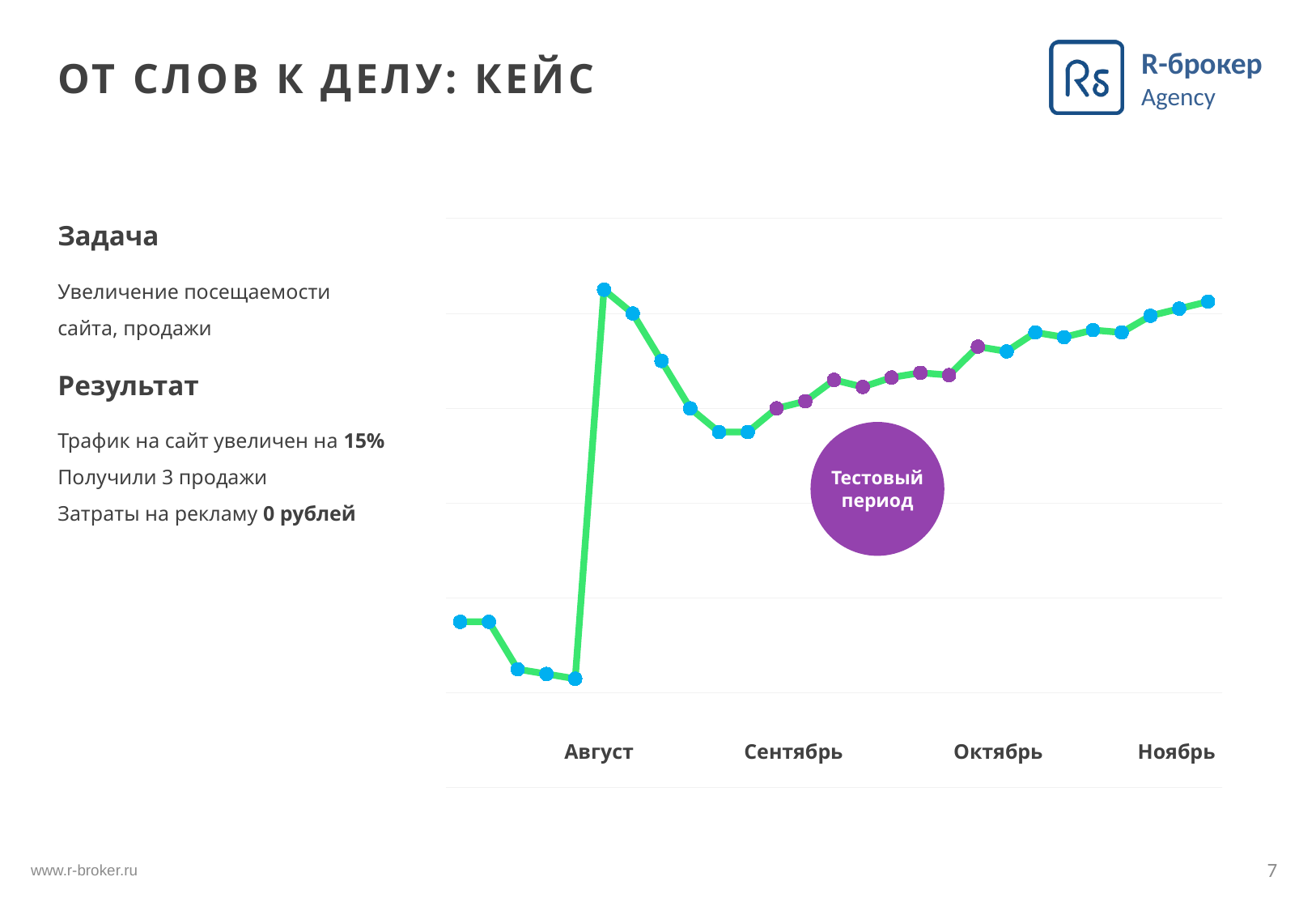
Near which month label does the line reach its highest point? Август How many month labels are shown along the x axis of the chart? 4 Is the value at Ноябрь higher or lower than the value at Сентябрь? higher Does the line rise or fall from its first point to the point just before the sharp jump near Август? fall Which month label is the first one shown on the x axis? Август What text is written in the purple circle on the chart? Тестовый период Which month labels appear along the x axis of the chart? Август, Сентябрь, Октябрь, Ноябрь Does the line rise or fall between Сентябрь and Ноябрь? rise Is the peak near Август higher or lower than the last point at Ноябрь? higher Near which month label does the line reach its lowest point? Август What kind of chart is shown on the slide? line chart